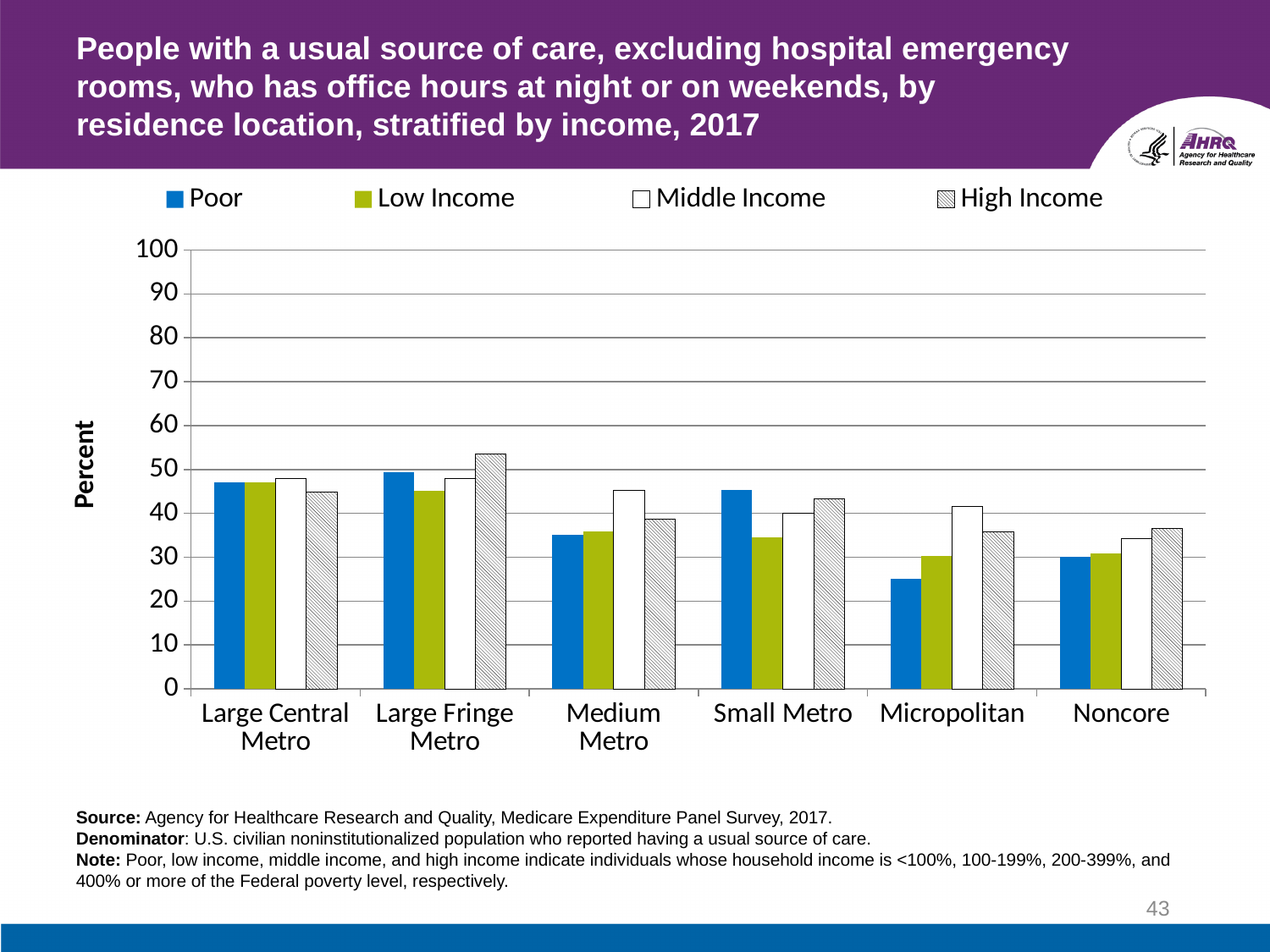
In Medium Metro, which is larger: the Poor value or the Middle Income value? Middle Income Is the value for High Income in Large Fringe Metro greater or less than 50? greater In Micropolitan, which income group has the highest value? Middle Income Which residence location has the highest value for High Income? Large Fringe Metro What kind of chart is shown on the slide? Bar chart Which residence location has the lowest value for Poor? Micropolitan Is the value for Middle Income in Micropolitan greater or less than 40? greater Is the value for Poor in Micropolitan greater or less than 30? less In Small Metro, which is larger: the Poor value or the Low Income value? Poor How many residence location categories are shown on the x axis? 6 What is the label on the y axis? Percent How many income groups does the legend list? 4